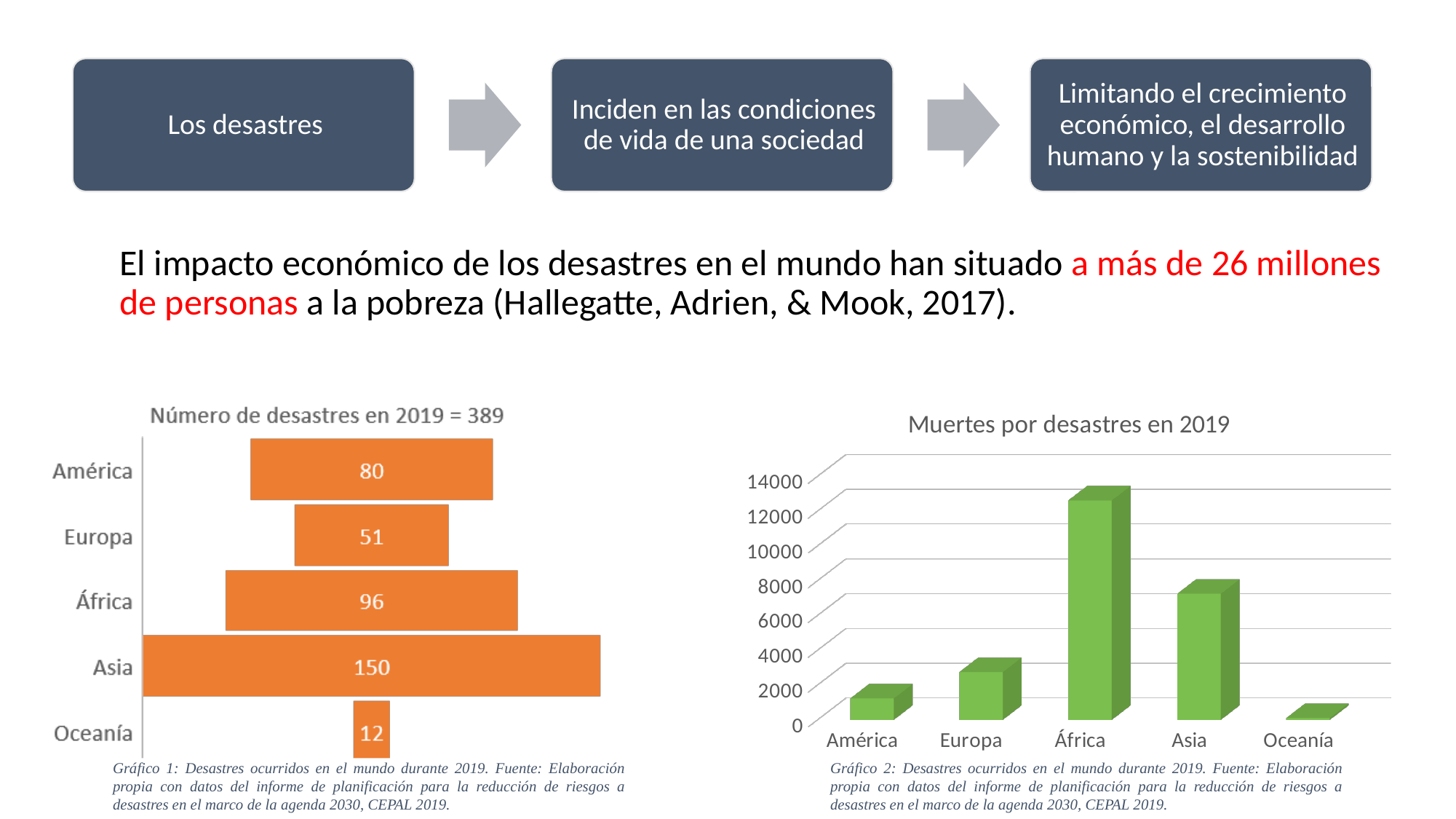
In the chart titled 'Número de desastres en 2019 = 389', how many regions are shown? 5 In the chart titled 'Muertes por desastres en 2019', is the value for Europa greater or less than 4000? less In the chart titled 'Muertes por desastres en 2019', which is larger, the value for Asia or the value for Europa? Asia In the chart titled 'Muertes por desastres en 2019', is the value for Asia greater or less than 6000? greater In the chart titled 'Número de desastres en 2019 = 389', what is the difference between the values for África and América? 16 In the chart titled 'Número de desastres en 2019 = 389', what is the value for Europa? 51 In the chart titled 'Muertes por desastres en 2019', which region has the highest value? África In the chart titled 'Número de desastres en 2019 = 389', which region has the highest value? Asia What kind of chart is the chart titled 'Número de desastres en 2019 = 389'? Bar chart In the chart titled 'Número de desastres en 2019 = 389', what is the value for Asia? 150 In the chart titled 'Número de desastres en 2019 = 389', which is larger, the value for América or the value for Europa? América In the chart titled 'Número de desastres en 2019 = 389', which region has the lowest value? Oceanía